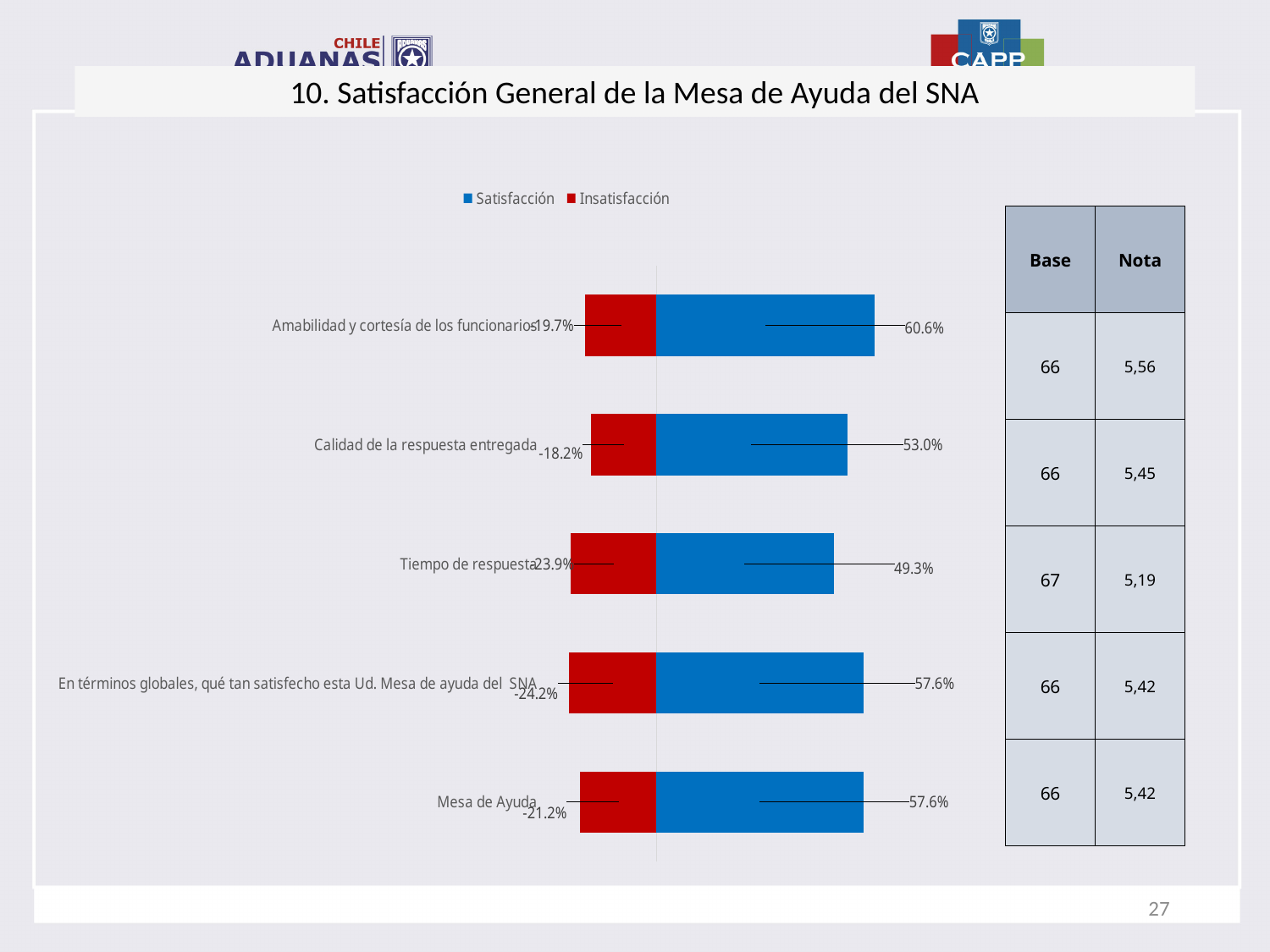
Which category has the lowest Satisfacción value? Tiempo de respuesta Which category has the highest Satisfacción value? Amabilidad y cortesía de los funcionarios What kind of chart is shown on the slide? bar chart What is the Insatisfacción value for Mesa de Ayuda? -21.2% Which has a larger Satisfacción value, Calidad de la respuesta entregada or Mesa de Ayuda? Mesa de Ayuda How many categories are plotted in the chart? 5 What is the difference between the Satisfacción values for Amabilidad y cortesía de los funcionarios and Tiempo de respuesta? 11.3% How many series does the chart legend list? 2 What is the Insatisfacción value for Tiempo de respuesta? -23.9% What is the Satisfacción value for Amabilidad y cortesía de los funcionarios? 60.6% Which colour represents the Insatisfacción series in the chart? red What is the Satisfacción value for Calidad de la respuesta entregada? 53.0%